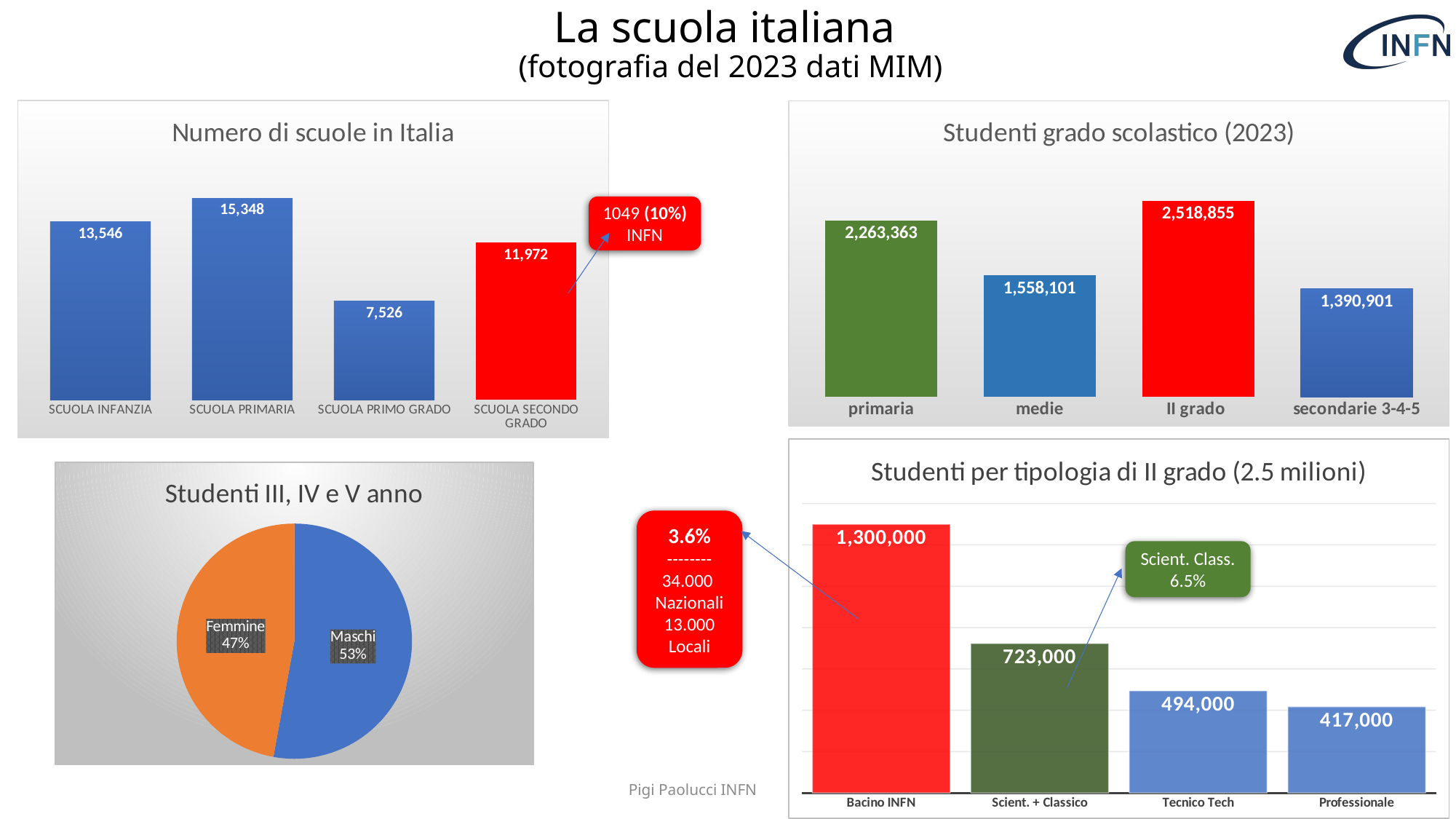
In the pie chart 'Studenti III, IV e V anno', what share is Femmine? 47% In the chart 'Studenti per tipologia di II grado (2.5 milioni)', do the values rise or fall from left to right? Fall In the chart 'Studenti grado scolastico (2023)', which category has the highest value? II grado In the chart 'Studenti grado scolastico (2023)', which is larger, primaria or secondarie 3-4-5? primaria In the chart 'Studenti per tipologia di II grado (2.5 milioni)', what is the difference between Bacino INFN and Scient. + Classico? 577,000 In the chart 'Studenti grado scolastico (2023)', what is the value for medie? 1,558,101 In the chart 'Studenti per tipologia di II grado (2.5 milioni)', what is the value for Tecnico Tech? 494,000 In the chart 'Numero di scuole in Italia', which category has the lowest value? SCUOLA PRIMO GRADO In the chart 'Numero di scuole in Italia', what is the difference between SCUOLA INFANZIA and SCUOLA SECONDO GRADO? 1,574 In the chart 'Numero di scuole in Italia', how many categories are shown? 4 In the chart 'Numero di scuole in Italia', what is the value for SCUOLA PRIMARIA? 15,348 What kind of chart is 'Studenti III, IV e V anno'? Pie chart